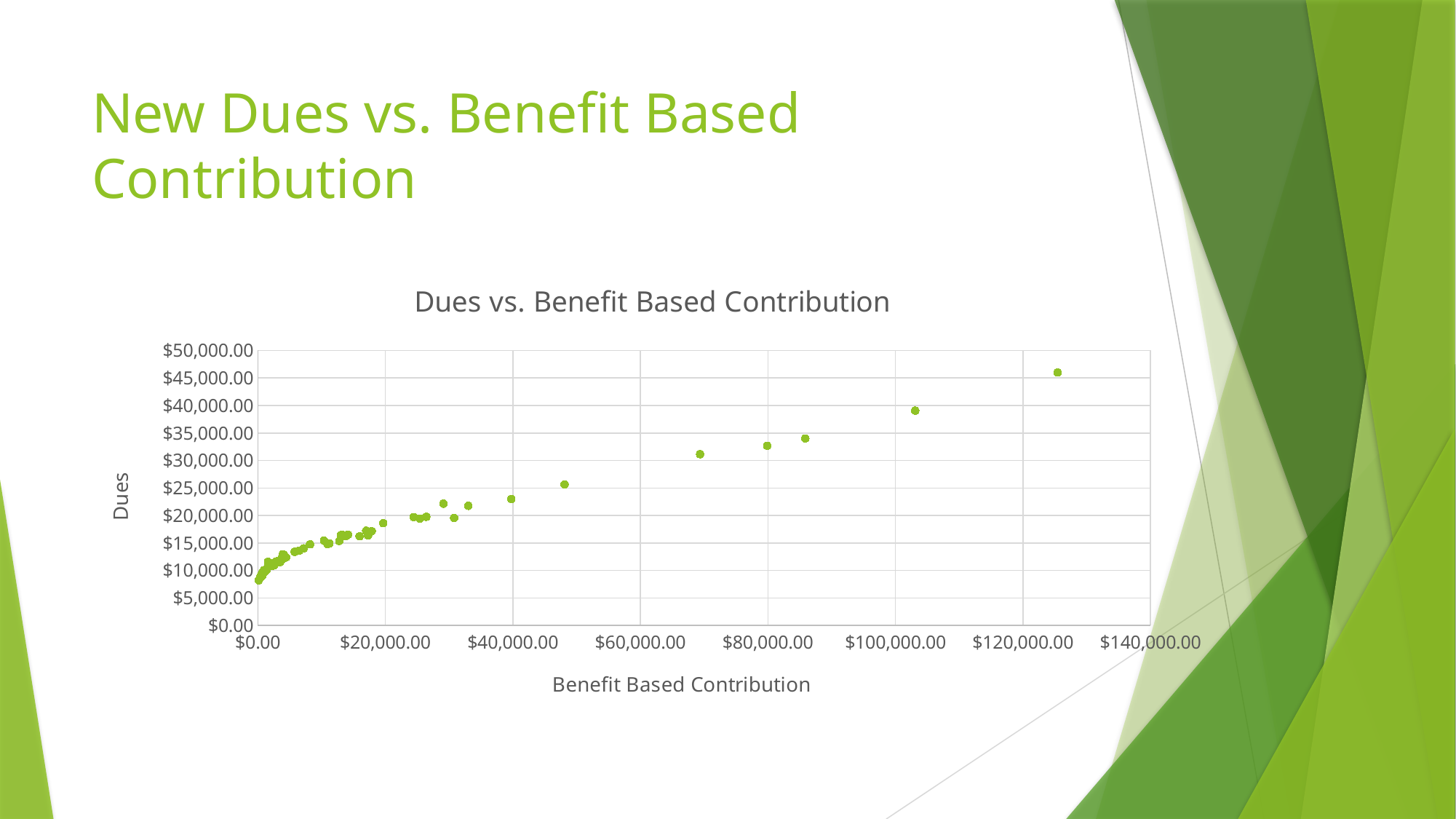
Is the Dues value for the point near $40,000.00 Benefit Based Contribution greater or less than $25,000.00? less Which has higher Dues: the point near $120,000.00 Benefit Based Contribution or the point near $80,000.00 Benefit Based Contribution? The point near $120,000.00 As Benefit Based Contribution increases along the x axis, do Dues generally rise or fall? Rise What kind of chart is shown on the slide? Scatter chart Is the Dues value for the point with the highest Benefit Based Contribution greater or less than $40,000.00? greater Does the point with the highest Dues also have the highest Benefit Based Contribution? Yes Is the Dues value for the point with the highest Benefit Based Contribution greater or less than $50,000.00? less What is the label on the vertical axis of the chart? Dues What is the title of the chart? Dues vs. Benefit Based Contribution